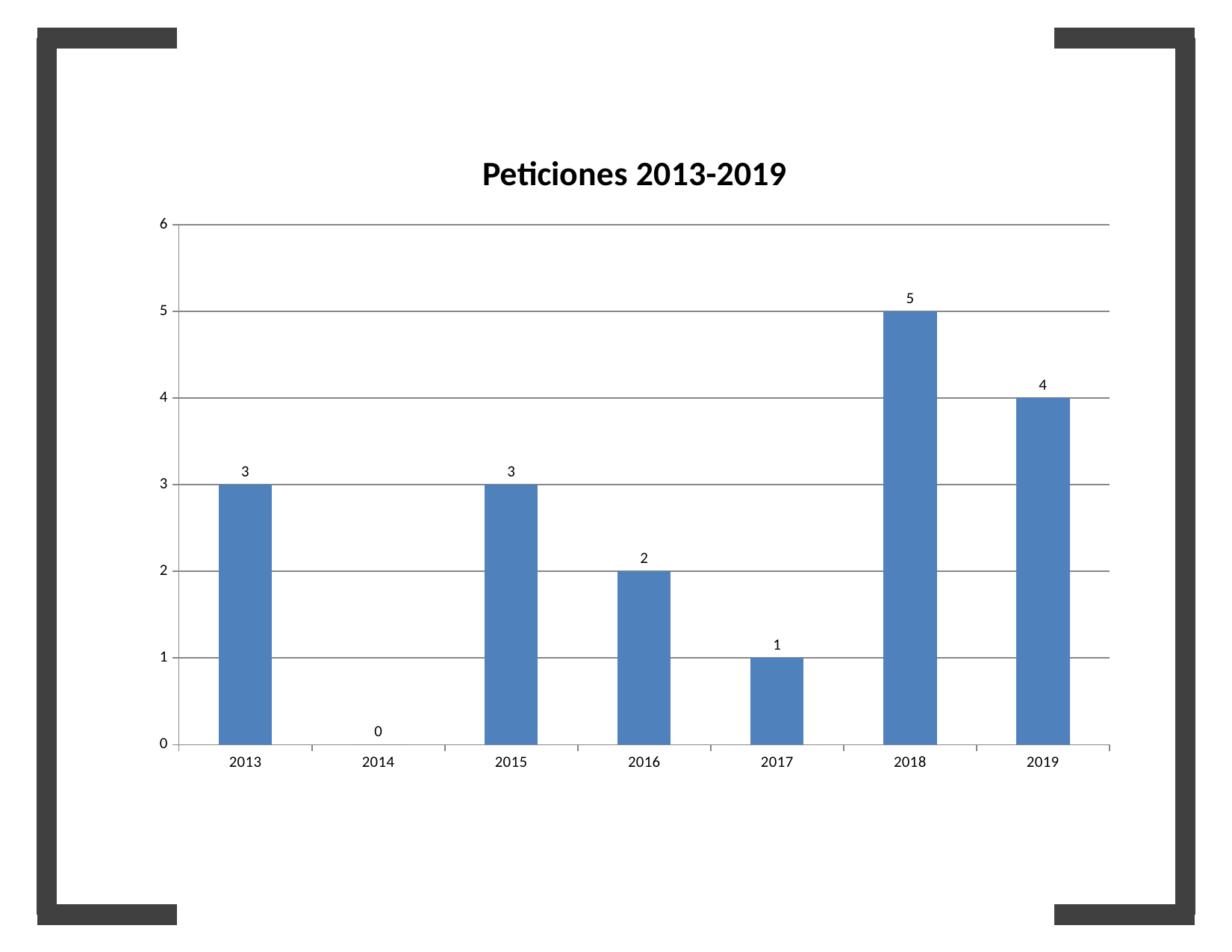
Do the values rise or fall from 2016 to 2017? fall Which is larger, the value for 2019 or the value for 2015? 2019 Which year has the highest value? 2018 What is the value for 2014? 0 What kind of chart is this? bar chart What is the value for 2018? 5 What is the difference between the values for 2018 and 2017? 4 What is the value for 2016? 2 Which year has the lowest value? 2014 What is the difference between the values for 2013 and 2015? 0 What is the title of the chart? Peticiones 2013-2019 How many years are shown on the x axis? 7